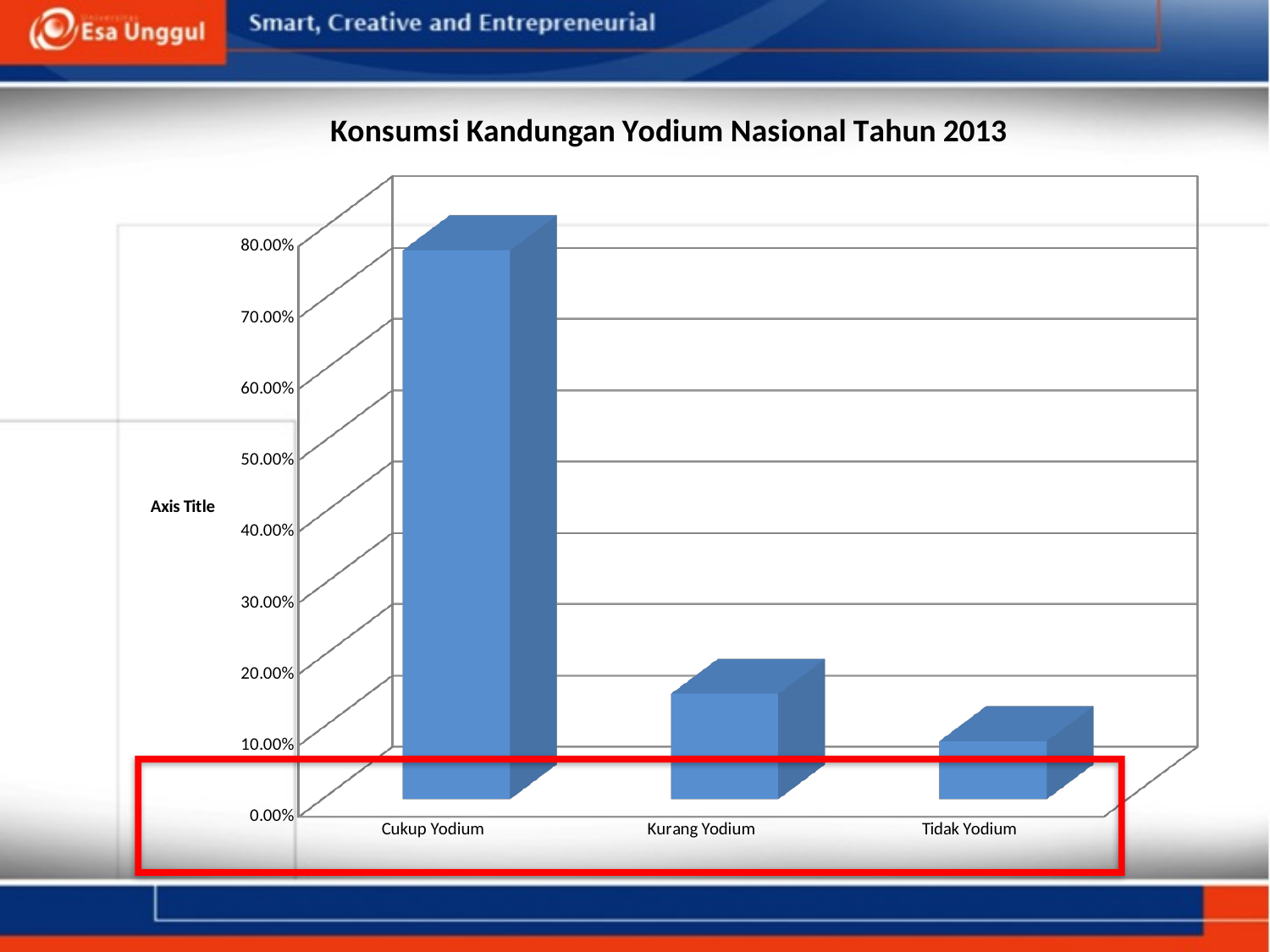
Which is larger, the value for Cukup Yodium or the value for Kurang Yodium? Cukup Yodium How many categories are shown on the x axis of the chart? 3 Is the value for Tidak Yodium greater or less than 20.00%? less Which category has the lowest value in the chart? Tidak Yodium Do the values rise or fall from left to right along the x axis? fall Which is larger, the value for Kurang Yodium or the value for Tidak Yodium? Kurang Yodium Is the value for Cukup Yodium greater or less than 50.00%? greater Is the value for Cukup Yodium greater or less than 60.00%? greater Which category has the highest value in the chart? Cukup Yodium What is the title of the chart? Konsumsi Kandungan Yodium Nasional Tahun 2013 What type of chart is shown on the slide? bar chart